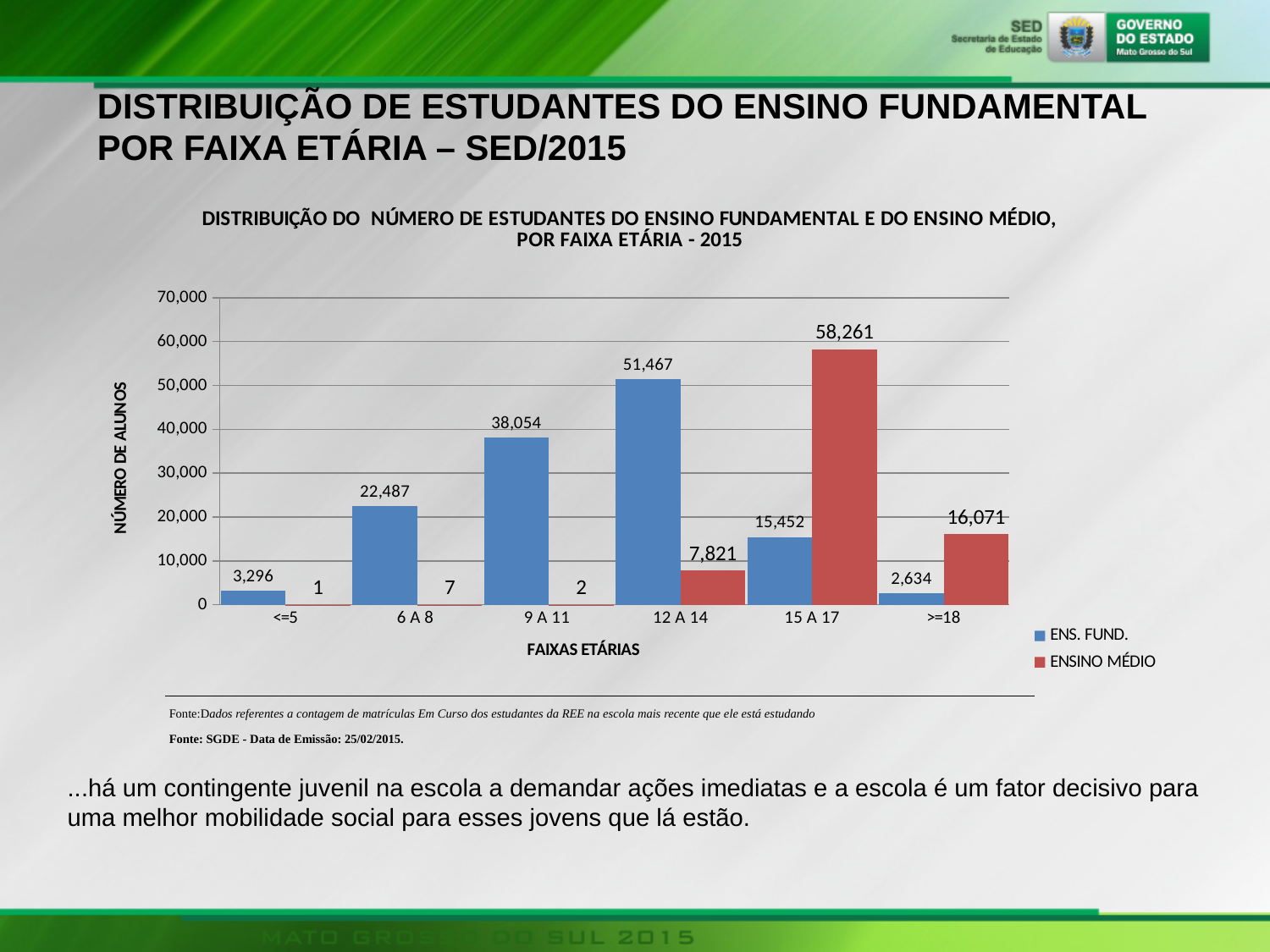
What is the value for ENSINO MÉDIO in the >=18 age group? 16,071 What kind of chart is shown on the slide? Bar chart What is the value for ENS. FUND. in the 6 A 8 age group? 22,487 How many age groups are shown on the x axis? 6 Which age group has the lowest value for ENS. FUND.? >=18 What is the label of the y axis? NÚMERO DE ALUNOS What is the difference between the ENSINO MÉDIO value and the ENS. FUND. value in the 15 A 17 age group? 42,809 Which age group has the highest value for ENS. FUND.? 12 A 14 In the 12 A 14 age group, which series has the larger value, ENS. FUND. or ENSINO MÉDIO? ENS. FUND. How many series does the legend list? 2 What is the value for ENS. FUND. in the 12 A 14 age group? 51,467 What is the value for ENSINO MÉDIO in the 15 A 17 age group? 58,261